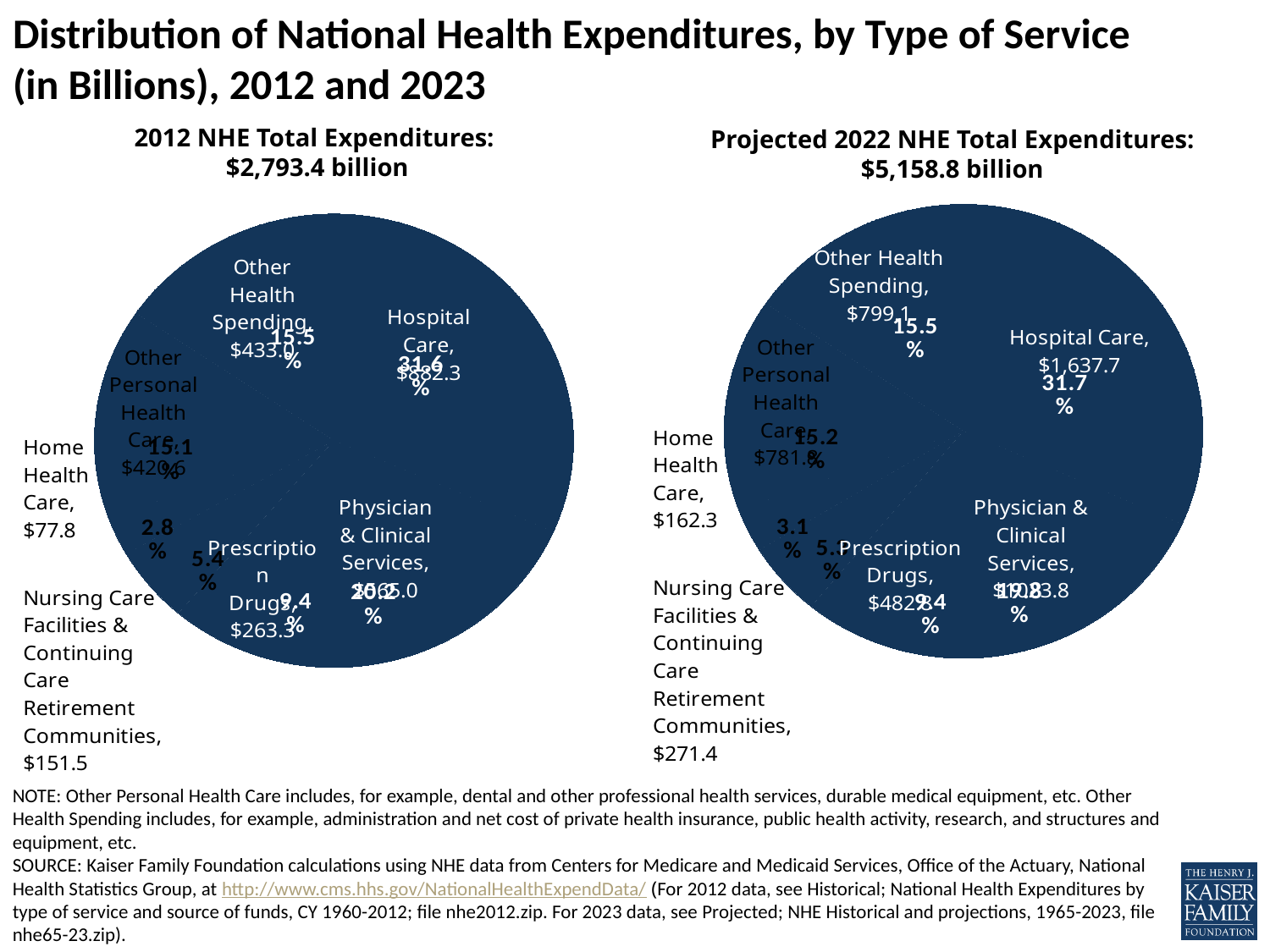
In the Projected 2022 NHE chart, what is the value for Home Health Care? $162.3 What is the difference between the Home Health Care values in the Projected 2022 chart and the 2012 chart? $84.5 In the 2012 NHE chart, what is the value for Nursing Care Facilities & Continuing Care Retirement Communities? $151.5 In the 2012 NHE chart, what is the value for Home Health Care? $77.8 In the 2012 NHE chart, which type of service has the smallest share? Home Health Care In the Projected 2022 NHE chart, which type of service has the largest share? Hospital Care In the Projected 2022 NHE chart, which is larger: Hospital Care or Other Health Spending? Hospital Care In the 2012 NHE chart, what share of the pie is Home Health Care? 2.8% In the Projected 2022 NHE chart, what is the value for Nursing Care Facilities & Continuing Care Retirement Communities? $271.4 What kind of charts are shown on the slide? Pie charts In the Projected 2022 NHE chart, what is the value for Hospital Care? $1,637.7 In the Projected 2022 NHE chart, what share of the pie is Hospital Care? 31.7%